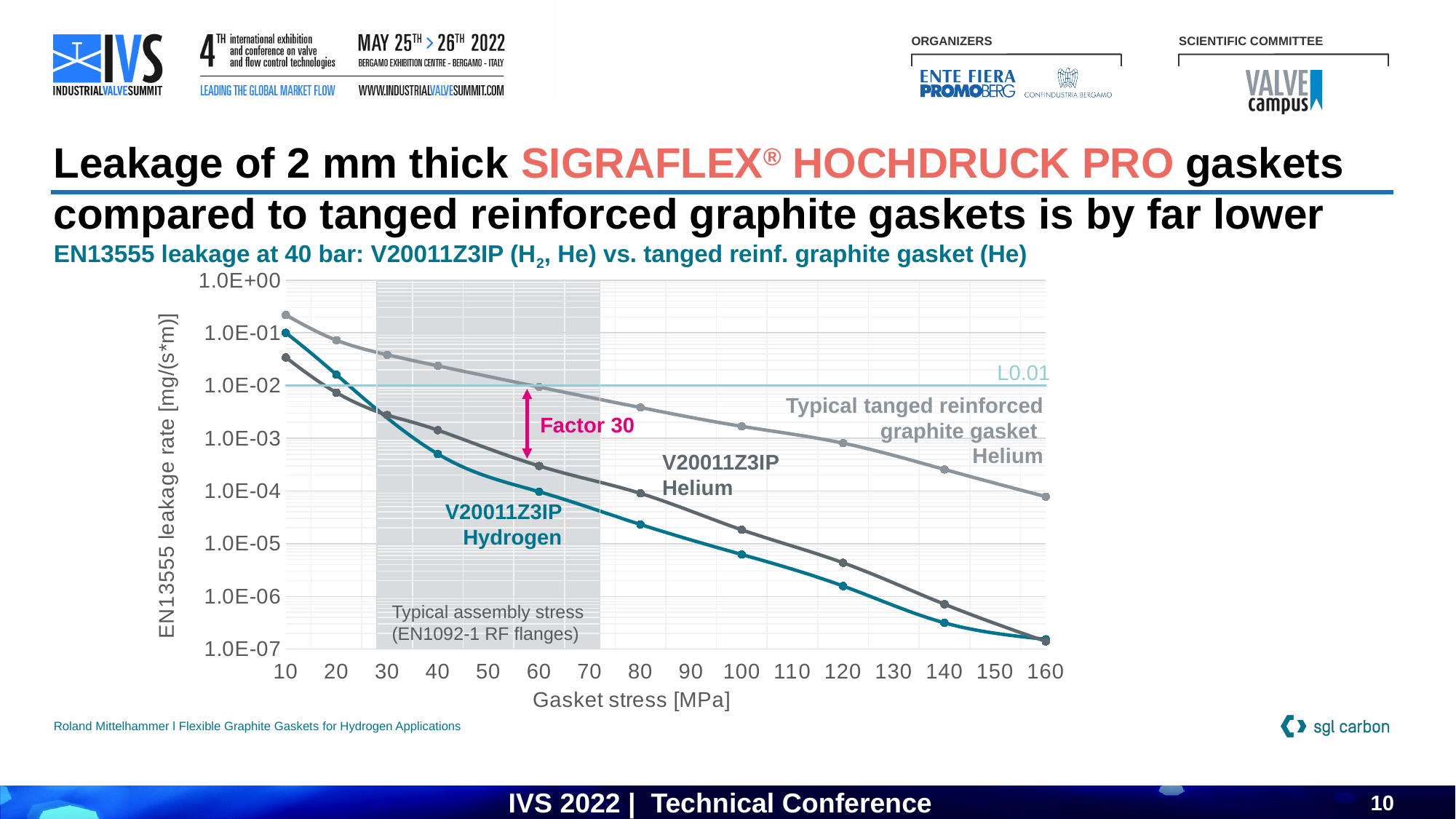
Do the leakage rates rise or fall as gasket stress increases along the x axis? Fall How many gasket stress values are labelled on the x axis? 16 Is the leakage rate of the typical tanged reinforced graphite gasket (Helium) at 10 MPa greater or less than 1.0E-01? greater At a gasket stress of 100 MPa, which series has the lowest leakage rate? V20011Z3IP Hydrogen At a gasket stress of 100 MPa, which series has the higher leakage rate: V20011Z3IP Hydrogen or V20011Z3IP Helium? V20011Z3IP Helium What is the label of the y axis of the chart? EN13555 leakage rate [mg/(s*m)] What is the label of the x axis of the chart? Gasket stress [MPa] At a gasket stress of 100 MPa, which series has the highest leakage rate? Typical tanged reinforced graphite gasket Helium What kind of chart is shown on the slide? Line chart Is the leakage rate of V20011Z3IP Helium at 100 MPa greater or less than 1.0E-05? greater Is the leakage rate of V20011Z3IP Hydrogen at 100 MPa greater or less than 1.0E-05? less